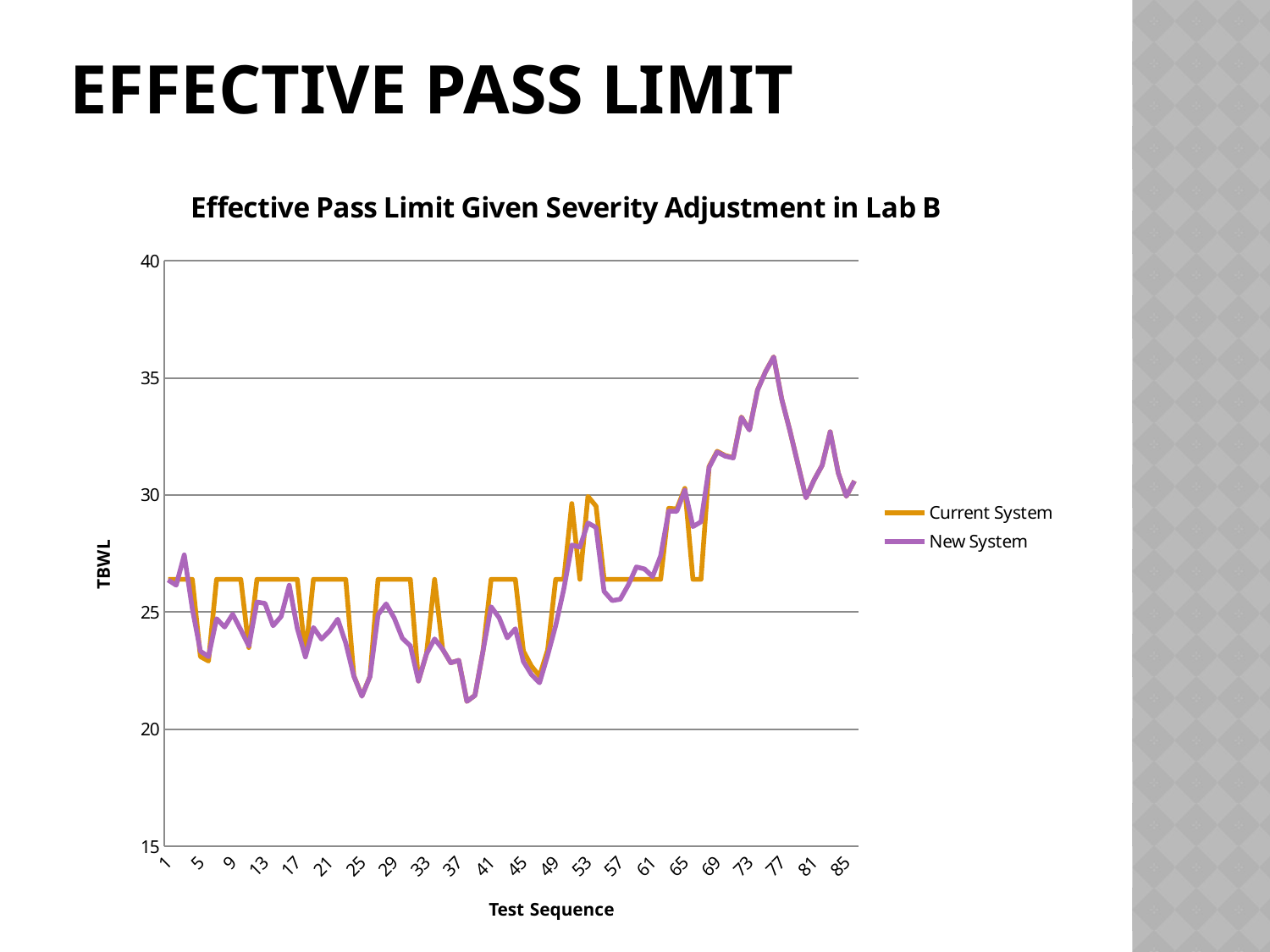
How many series does the legend list? 2 Does the New System line rise or fall between test sequence 69 and test sequence 77? Rise Is the New System value at test sequence 81 greater or less than 25? greater What kind of chart is shown on the slide? Line chart What are the two series named in the legend? Current System and New System What is the title of the chart? Effective Pass Limit Given Severity Adjustment in Lab B Is the New System value at test sequence 37 greater or less than 25? less Is the Current System value at test sequence 9 greater or less than 30? less